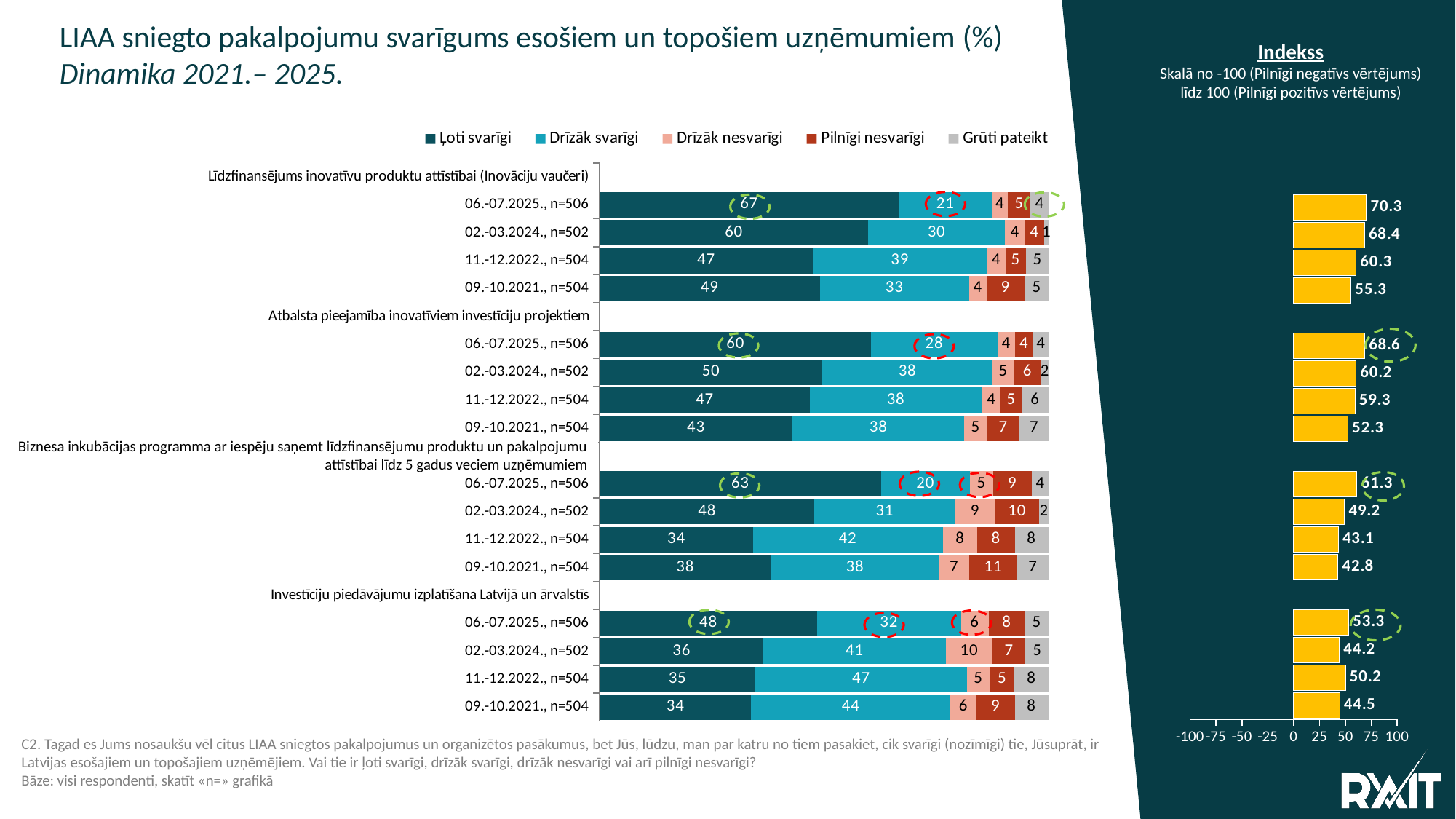
In the stacked bar chart, for "Investīciju piedāvājumu izplatīšana Latvijā un ārvalstīs", which wave has the larger "Drīzāk svarīgi" share: 11.-12.2022 or 09.-10.2021? 11.-12.2022 In the "Indekss" chart, what is the lowest index value shown? 42.8 In the stacked bar chart, how much higher is the "Ļoti svarīgi" share for "Atbalsta pieejamība inovatīviem investīciju projektiem" in 06.-07.2025 than in 02.-03.2024? 10 In the stacked bar chart, what percentage of respondents in 09.-10.2021 rated "Biznesa inkubācijas programma" as "Pilnīgi nesvarīgi"? 11 What kind of chart is the main chart on the left of the slide? stacked bar chart What is the title of the chart on the right side of the slide? Indekss In the stacked bar chart, what percentage of respondents in 06.-07.2025 rated "Līdzfinansējums inovatīvu produktu attīstībai (Inovāciju vaučeri)" as "Ļoti svarīgi"? 67 In the "Indekss" chart, what is the index value for "Investīciju piedāvājumu izplatīšana Latvijā un ārvalstīs" in 06.-07.2025? 53.3 In the stacked bar chart, how many survey waves are shown for each service? 4 How many series does the legend of the stacked bar chart list? 5 In the "Indekss" chart, does the index for "Līdzfinansējums inovatīvu produktu attīstībai (Inovāciju vaučeri)" rise or fall from 09.-10.2021 to 06.-07.2025? rise In the "Indekss" chart, what is the highest index value shown? 70.3